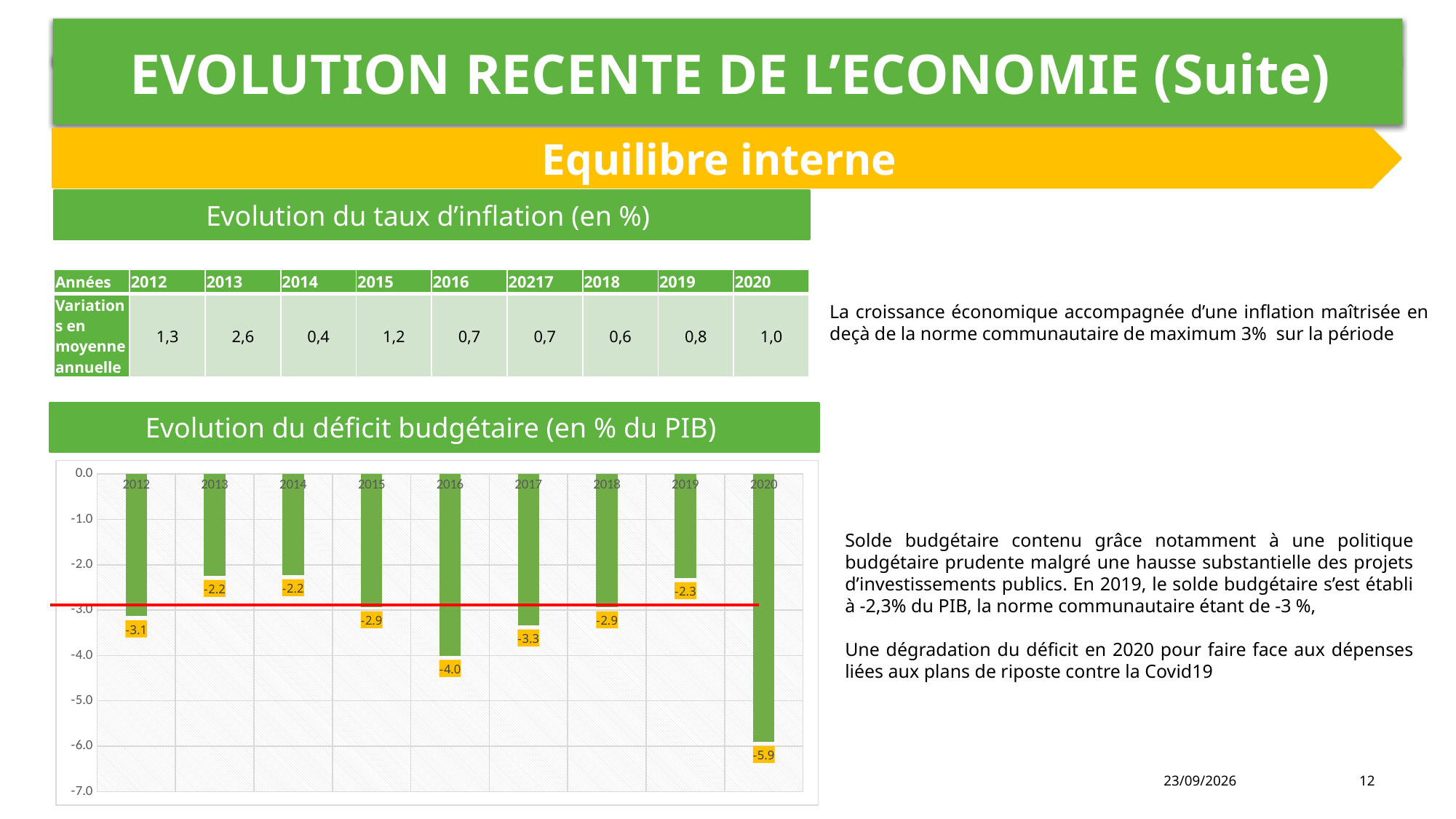
In the budget deficit chart, what is the value for 2019? -2.3 In the budget deficit chart, what is the difference between the 2020 value and the 2019 value? 3.6 In the budget deficit chart, which year has the lowest value (largest deficit)? 2020 In the budget deficit chart, what is the value for 2016? -4.0 In the budget deficit chart, at what level is the horizontal red line drawn? -3.0 In the budget deficit chart, what is the value for 2012? -3.1 In the budget deficit chart, is the value for 2016 greater or less than -3.0? less What type of chart is used to show the evolution of the budget deficit (en % du PIB)? bar chart In the budget deficit chart, what is the value for 2020? -5.9 In the budget deficit chart, which year has the larger deficit, 2016 or 2017? 2016 How many years are plotted in the budget deficit chart? 9